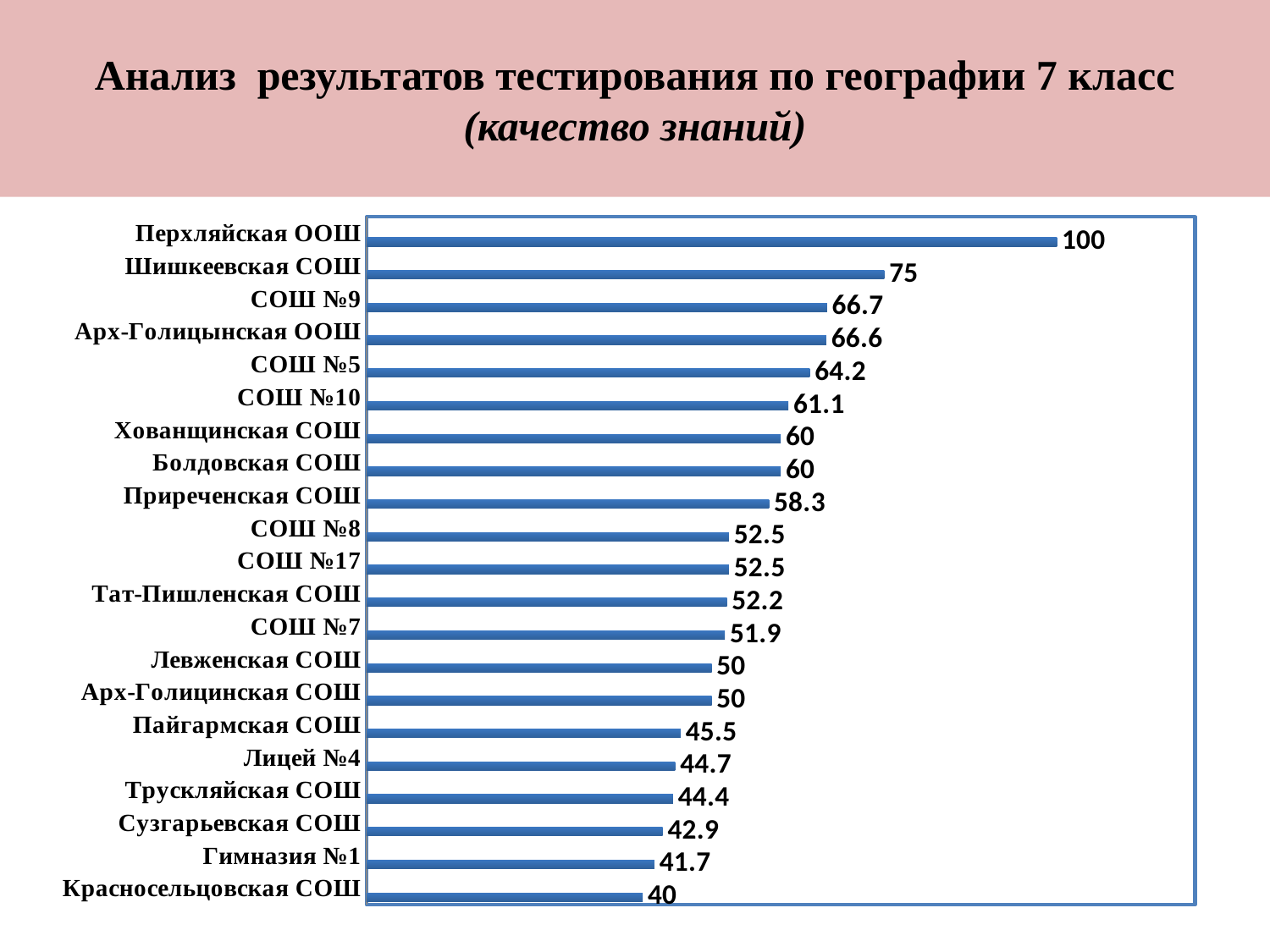
What is the difference between the values for СОШ №5 and Красносельцовская СОШ? 24.2 Which school has the highest value? Перхляйская ООШ How many schools are shown in the chart? 21 What is the value for Лицей №4? 44.7 What is the difference between the values for Перхляйская ООШ and Шишкеевская СОШ? 25 What is the value for Приреченская СОШ? 58.3 Which is larger, the value for СОШ №10 or the value for Пайгармская СОШ? СОШ №10 What kind of chart is shown on the slide? Bar chart Which school has the lowest value? Красносельцовская СОШ What is the title of the slide? Анализ результатов тестирования по географии 7 класс (качество знаний) What is the value for Шишкеевская СОШ? 75 What is the value for Гимназия №1? 41.7